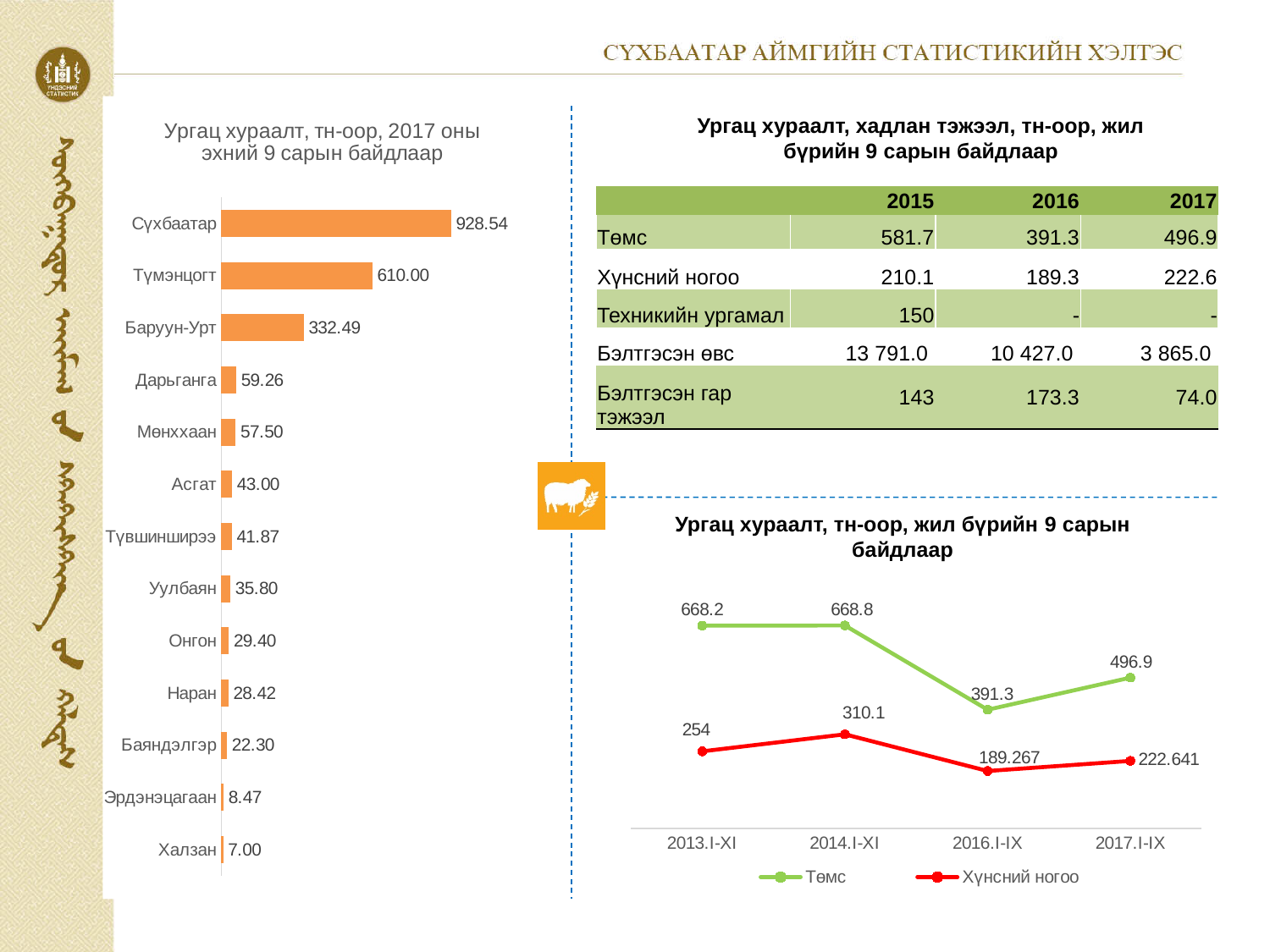
In the line chart at the bottom right, how many series does the legend list? 2 In the bar chart on the left, what is the value for Түмэнцогт? 610.00 In the bar chart on the left, which category has the lowest value? Халзан In the line chart at the bottom right, what is the difference between the Төмс values at 2017.I-IX and 2016.I-IX? 105.6 In the bar chart on the left, which category has the highest value? Сүхбаатар In the bar chart on the left, which is larger, the value for Дарьганга or the value for Асгат? Дарьганга In the line chart at the bottom right, does the Хүнсний ногоо series rise or fall from 2014.I-XI to 2016.I-IX? Fall In the bar chart on the left, how many categories are shown? 13 What kind of chart is the chart on the left of the slide? Bar chart In the line chart at the bottom right, what is the value for Хүнсний ногоо at 2017.I-IX? 222.641 In the line chart at the bottom right, what is the value for Төмс at 2016.I-IX? 391.3 In the bar chart on the left, what is the difference between the values for Сүхбаатар and Баруун-Урт? 596.05